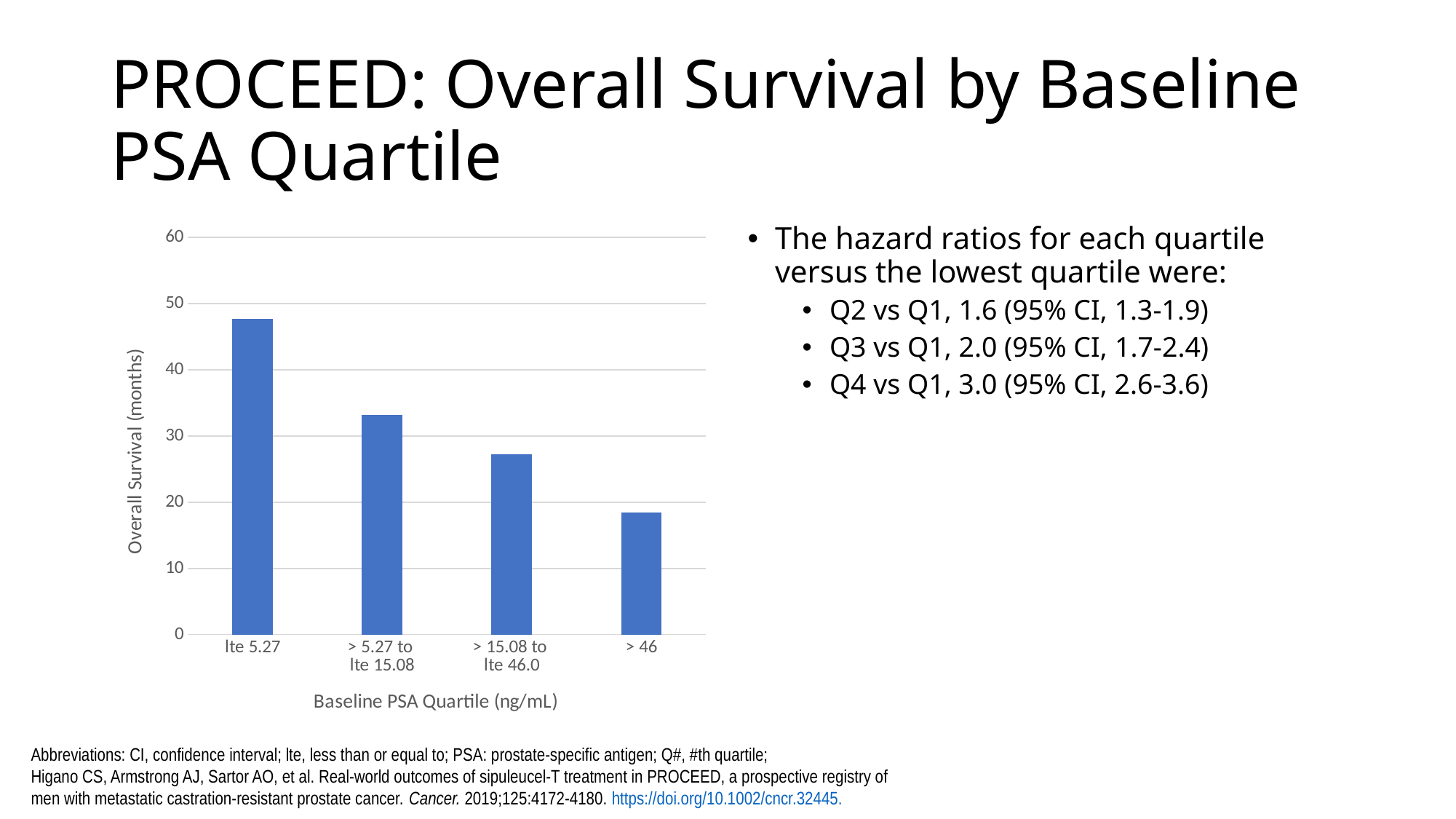
Is the overall survival for the > 15.08 to lte 46.0 quartile greater or less than 30 months? less Is the overall survival for the lte 5.27 quartile greater or less than 40 months? greater Is the overall survival for the > 46 quartile greater or less than 20 months? less Which baseline PSA quartile has the highest overall survival? lte 5.27 Which has higher overall survival: the > 5.27 to lte 15.08 quartile or the > 46 quartile? > 5.27 to lte 15.08 Does overall survival rise or fall as baseline PSA quartile increases along the x axis? fall How many baseline PSA quartile categories are plotted in the chart? 4 Which baseline PSA quartile has the lowest overall survival? > 46 What is the label of the x axis in the chart? Baseline PSA Quartile (ng/mL) What kind of chart is shown on the slide? bar chart What is the label of the y axis in the chart? Overall Survival (months)